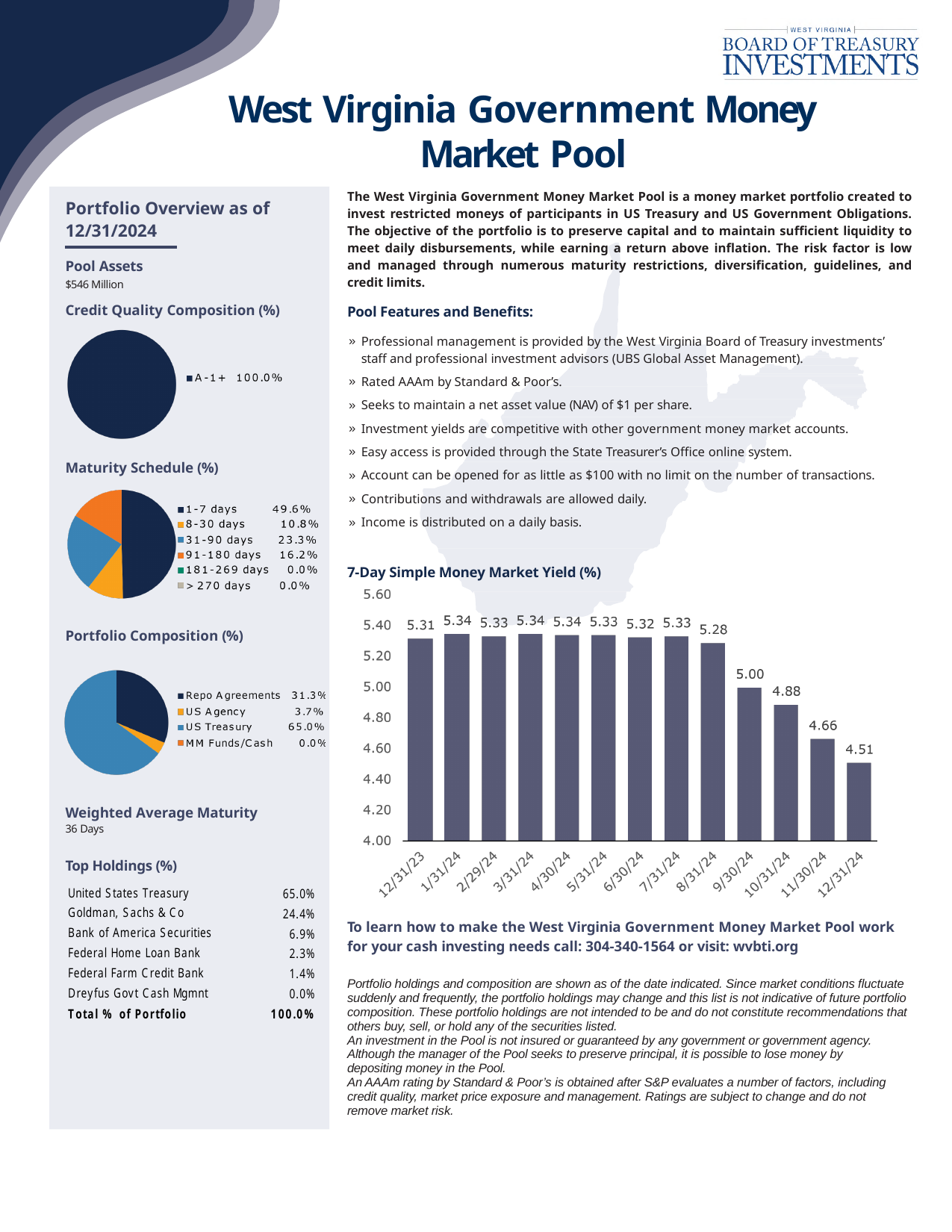
In the Portfolio Composition (%) pie chart, what share is Repo Agreements? 31.3% What kind of chart is the 7-Day Simple Money Market Yield (%) chart? Bar chart In the Maturity Schedule (%) pie chart, what share is 31-90 days? 23.3% In the 7-Day Simple Money Market Yield (%) chart, do the values generally rise or fall from 8/31/24 to 12/31/24? Fall In the 7-Day Simple Money Market Yield (%) chart, what is the value for 12/31/24? 4.51 In the 7-Day Simple Money Market Yield (%) chart, which date has the lowest yield? 12/31/24 In the 7-Day Simple Money Market Yield (%) chart, what is the difference between the values for 12/31/23 and 12/31/24? 0.80 In the 7-Day Simple Money Market Yield (%) chart, which is larger, the value for 8/31/24 or the value for 10/31/24? 8/31/24 In the Maturity Schedule (%) pie chart, which maturity bucket has the largest share? 1-7 days In the 7-Day Simple Money Market Yield (%) chart, how many dates are plotted? 13 In the 7-Day Simple Money Market Yield (%) chart, what is the value for 9/30/24? 5.00 In the Credit Quality Composition (%) pie chart, what share is A-1+? 100.0%